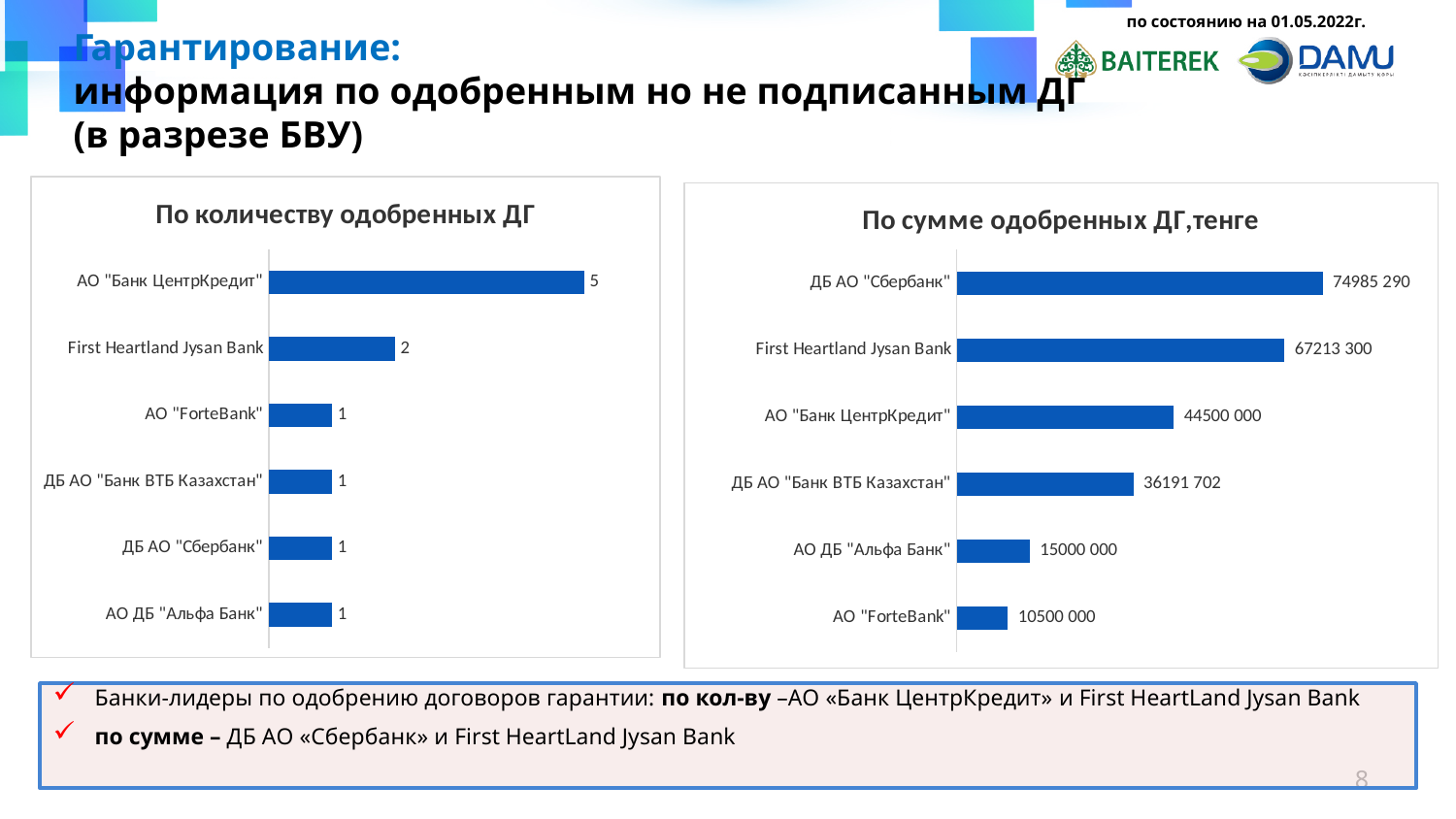
In the chart "По сумме одобренных ДГ,тенге", which bank has the lowest value? АО "ForteBank" In the chart "По сумме одобренных ДГ,тенге", what is the value for ДБ АО "Сбербанк"? 74985 290 In the chart "По сумме одобренных ДГ,тенге", what is the difference between АО ДБ "Альфа Банк" and АО "ForteBank"? 4500 000 In the chart "По количеству одобренных ДГ", what is the value for АО "Банк ЦентрКредит"? 5 What is the title of the chart on the left side of the slide? По количеству одобренных ДГ In the chart "По сумме одобренных ДГ,тенге", which is larger: АО "Банк ЦентрКредит" or ДБ АО "Банк ВТБ Казахстан"? АО "Банк ЦентрКредит" In the chart "По количеству одобренных ДГ", what is the difference between АО "Банк ЦентрКредит" and First Heartland Jysan Bank? 3 What type of chart is "По сумме одобренных ДГ,тенге"? Bar chart In the chart "По количеству одобренных ДГ", what is the value for First Heartland Jysan Bank? 2 In the chart "По количеству одобренных ДГ", how many banks are shown? 6 In the chart "По количеству одобренных ДГ", which bank has the highest value? АО "Банк ЦентрКредит" In the chart "По сумме одобренных ДГ,тенге", what is the value for ДБ АО "Банк ВТБ Казахстан"? 36191 702